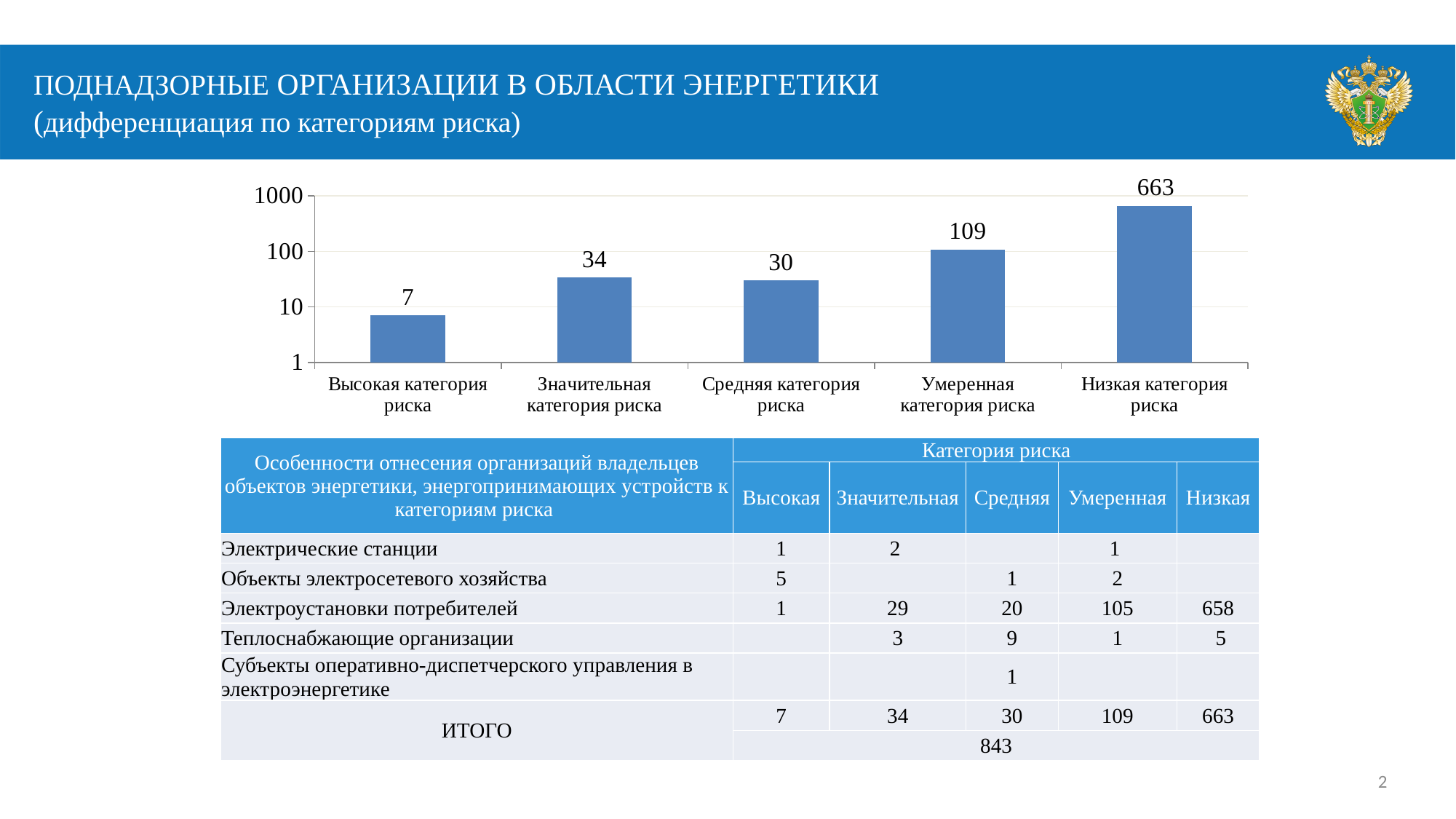
What is the difference between the values for "Значительная категория риска" and "Средняя категория риска"? 4 Which category has the lowest value in the bar chart? Высокая категория риска How many categories are shown in the bar chart? 5 What is the value for "Высокая категория риска" in the bar chart? 7 What is the value for "Низкая категория риска" in the bar chart? 663 Which is larger: the value for "Умеренная категория риска" or "Средняя категория риска"? Умеренная категория риска Is the value for "Умеренная категория риска" greater or less than 100? greater Which category has the highest value in the bar chart? Низкая категория риска What is the difference between the values for "Низкая категория риска" and "Умеренная категория риска"? 554 What kind of chart is shown on the slide? bar chart What is the value for "Умеренная категория риска" in the bar chart? 109 What is the value for "Значительная категория риска" in the bar chart? 34